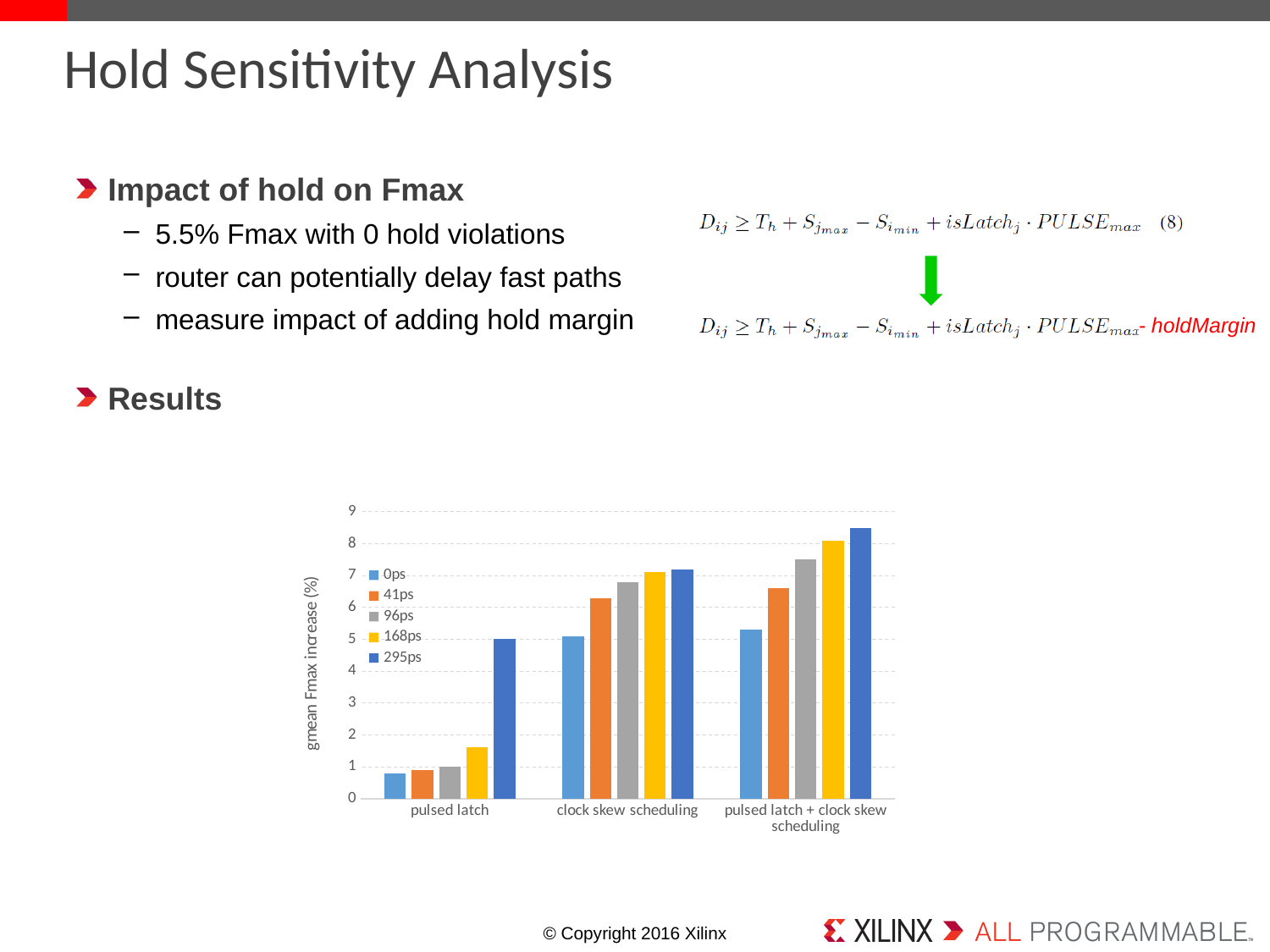
Which series has the highest bar in the 'pulsed latch + clock skew scheduling' group? 295ps How many series does the chart legend list? 5 Which hold margin series is listed last in the chart legend? 295ps Is the 168ps value for 'pulsed latch' greater or less than 2? less Which series has the highest bar in the 'pulsed latch' group? 295ps Which is larger: the 96ps value for 'clock skew scheduling' or the 96ps value for 'pulsed latch + clock skew scheduling'? pulsed latch + clock skew scheduling Which category has the lowest bar for the 0ps series? pulsed latch How many categories are shown on the x axis of the chart? 3 Is the 295ps value for 'pulsed latch + clock skew scheduling' greater or less than 8? greater Within the 'clock skew scheduling' group, do the bars rise or fall as the hold margin increases from 0ps to 295ps? rise What kind of chart is shown on the slide? bar chart What is the label of the vertical axis of the chart? gmean Fmax increase (%)